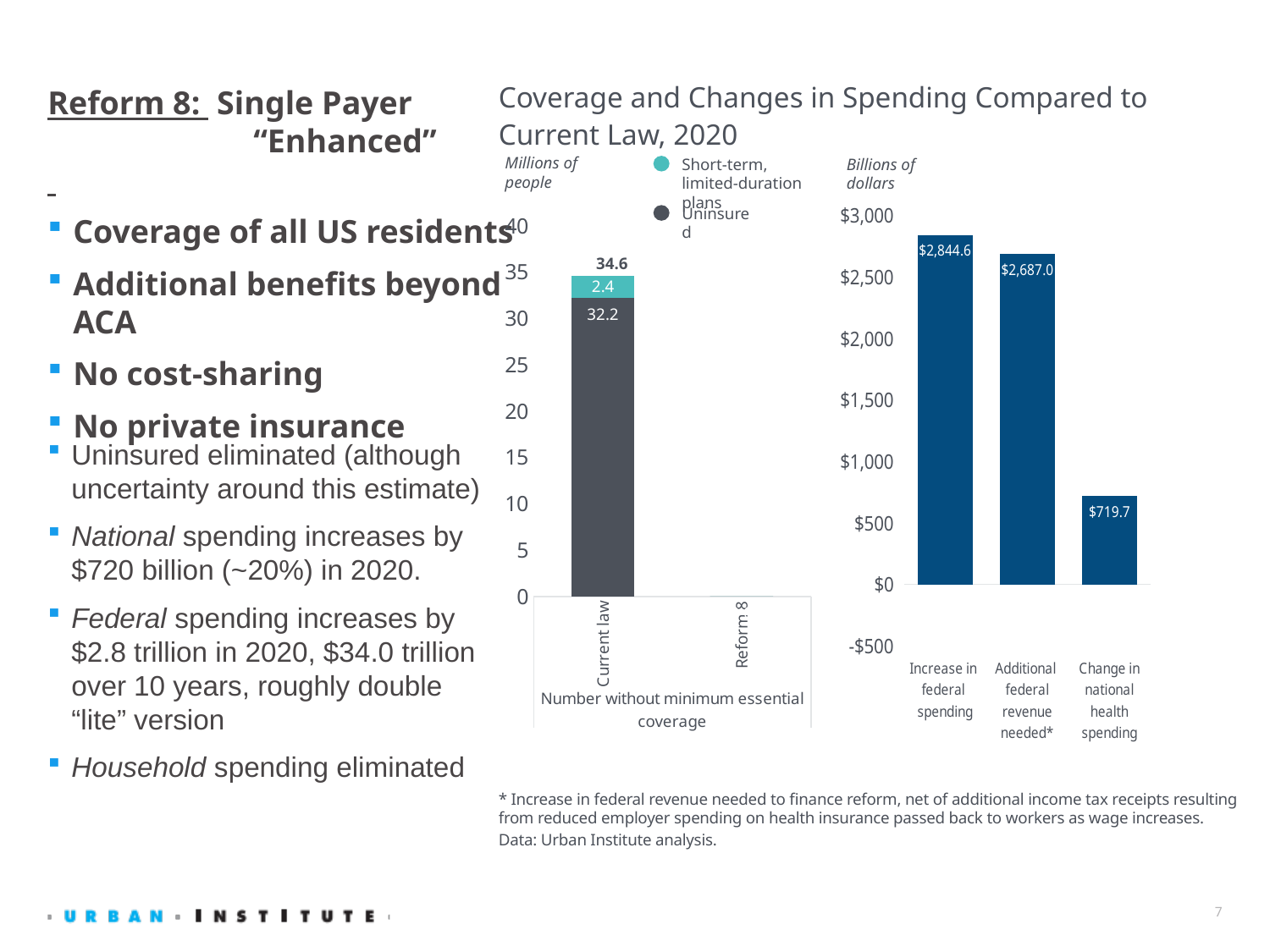
In the left-hand chart (Number without minimum essential coverage), how many series does the legend list? 2 In the right-hand chart (billions of dollars), what is the value for Increase in federal spending? $2,844.6 In the right-hand chart (billions of dollars), which category has the lowest value? Change in national health spending In the right-hand chart (billions of dollars), what is the value for Additional federal revenue needed? $2,687.0 In the right-hand chart (billions of dollars), what is the difference between Increase in federal spending and Additional federal revenue needed? $157.6 In the left-hand chart (Number without minimum essential coverage), what is the Short-term, limited-duration plans value for Current law? 2.4 In the right-hand chart (billions of dollars), how many bars are plotted? 3 In the right-hand chart (billions of dollars), what is the value for Change in national health spending? $719.7 In the right-hand chart (billions of dollars), which category has the highest value? Increase in federal spending What kind of chart is the right-hand chart (billions of dollars)? Bar chart In the left-hand chart (Number without minimum essential coverage), what is the Uninsured value for Current law? 32.2 In the left-hand chart (Number without minimum essential coverage), what is the total of the stacked bar for Current law? 34.6